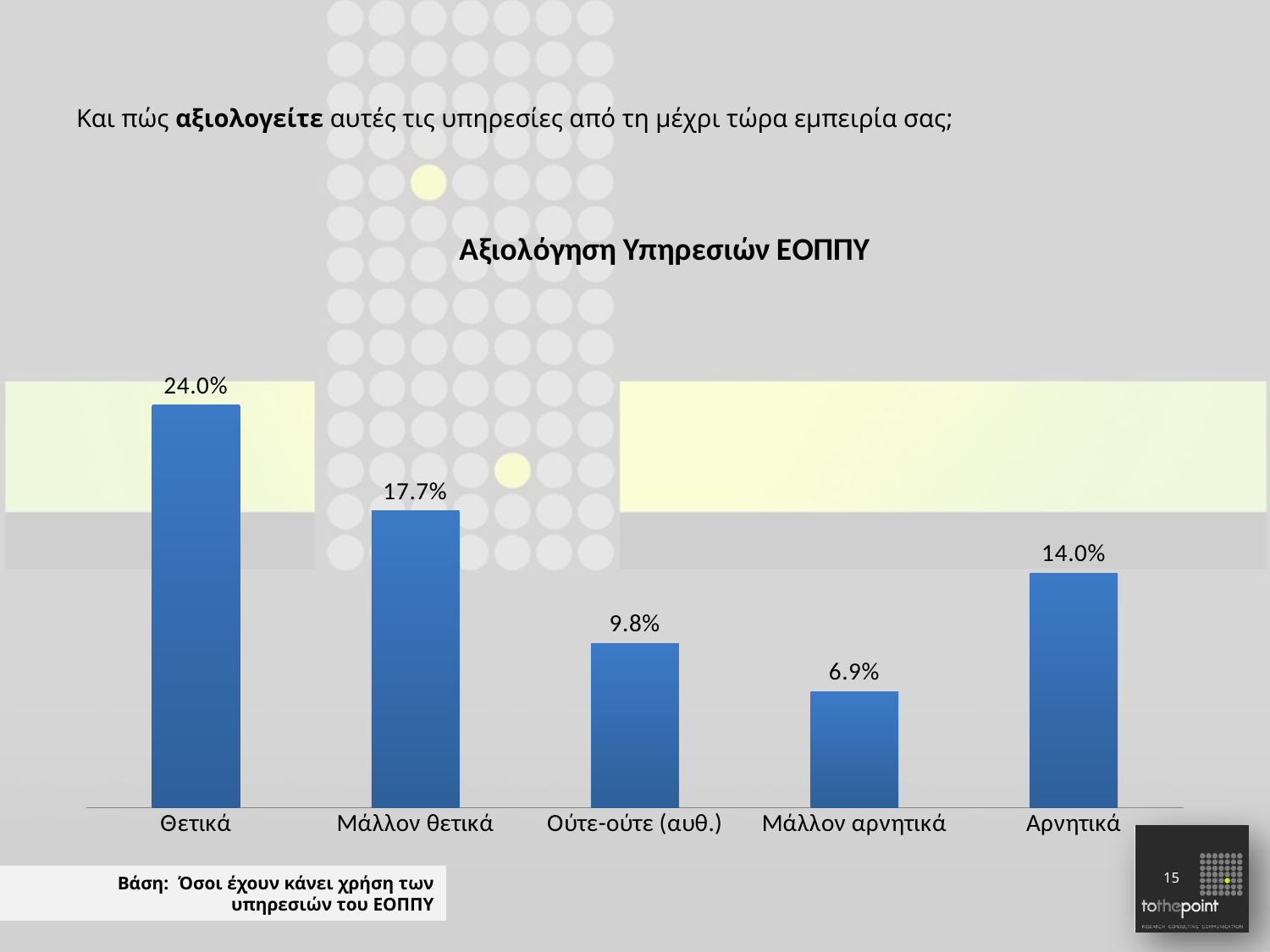
What is the difference between the values for Θετικά and Αρνητικά? 10.0% Which category has the lowest value? Μάλλον αρνητικά What is the value for Θετικά? 24.0% What is the value for Αρνητικά? 14.0% What kind of chart is shown on the slide? Bar chart What is the title of the chart? Αξιολόγηση Υπηρεσιών ΕΟΠΠΥ How many categories are shown in the chart? 5 Which category has the highest value? Θετικά What is the value for Ούτε-ούτε (αυθ.)? 9.8% Which is larger, the value for Μάλλον θετικά or the value for Αρνητικά? Μάλλον θετικά What is the value for Μάλλον αρνητικά? 6.9% What is the value for Μάλλον θετικά? 17.7%